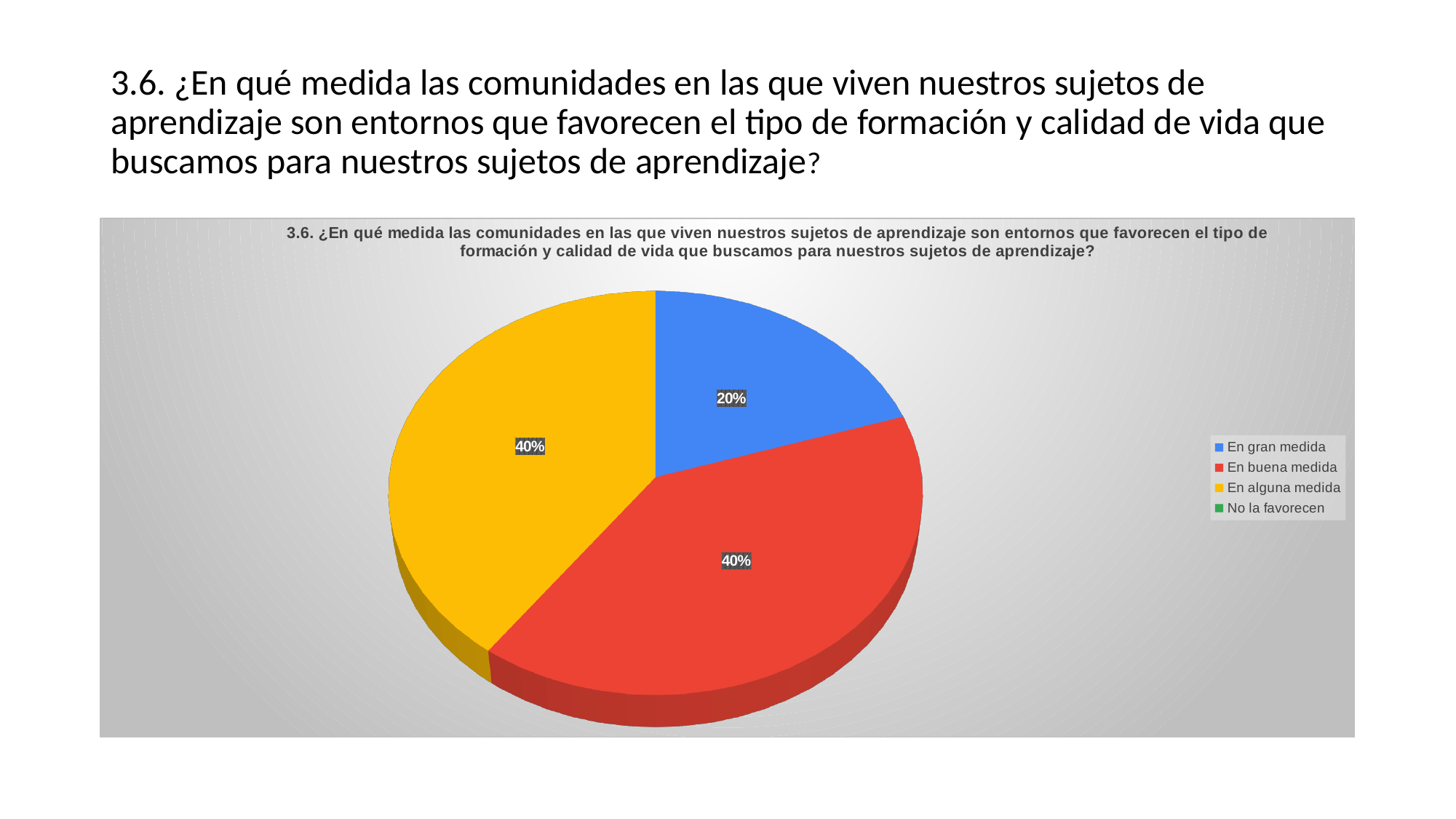
What kind of chart is shown on the slide? Pie chart Which legend entry is shown in green? No la favorecen What is the combined share of the "En buena medida" and "En alguna medida" slices? 80% What percentage of the pie is labelled for "En alguna medida"? 40% How many slices with data labels are visible in the pie? 3 What is the difference in percentage points between the "En alguna medida" slice and the "En gran medida" slice? 20 percentage points What percentage of the pie is labelled for "En buena medida"? 40% Which is larger, the share for "En buena medida" or the share for "En gran medida"? En buena medida Which colour represents "En alguna medida" in the pie chart? Yellow Is the share for "En gran medida" greater or less than 25%? less What percentage of the pie is labelled for "En gran medida"? 20% How many entries does the chart legend list? 4